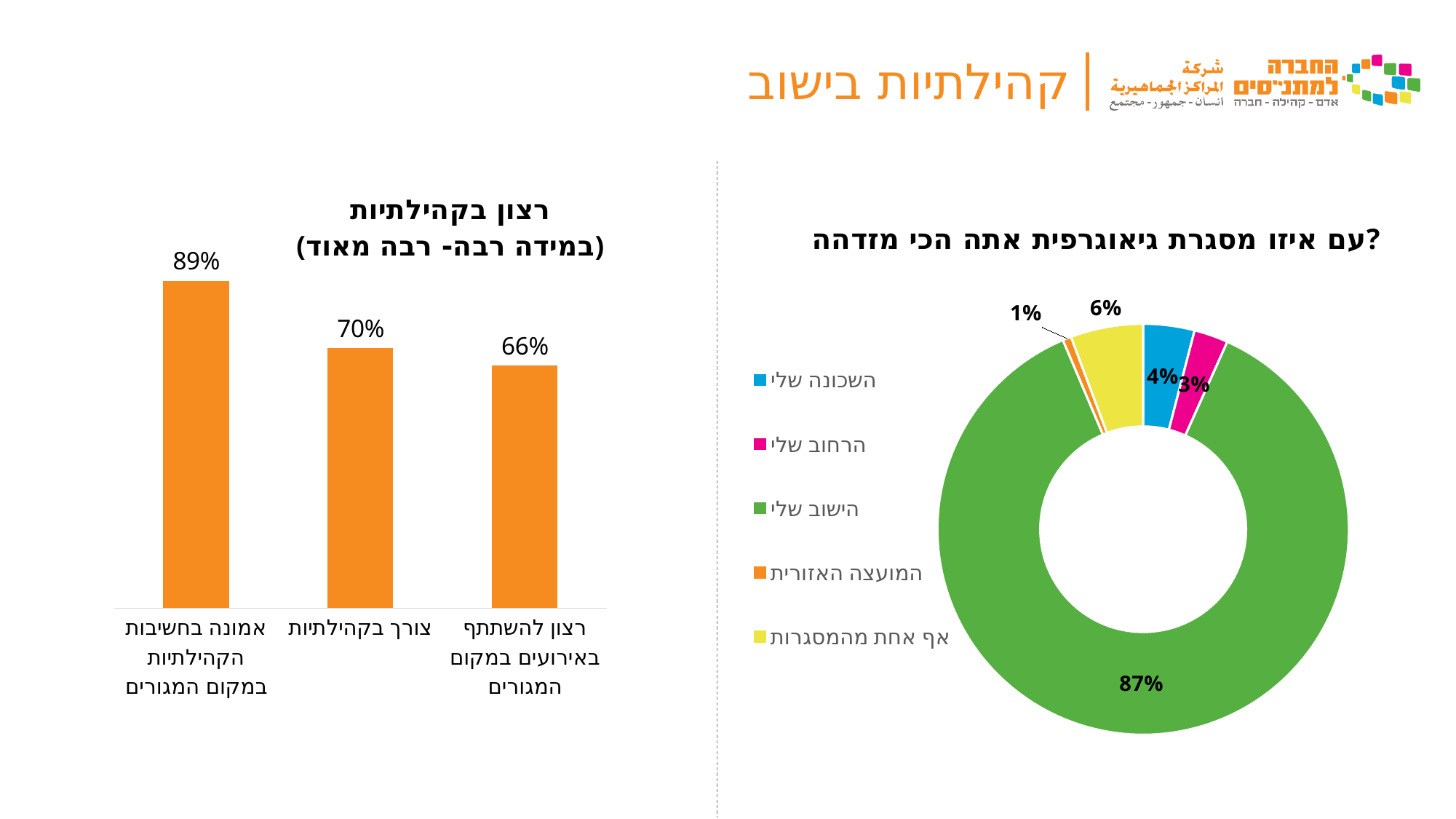
In the donut chart titled "עם איזו מסגרת גיאוגרפית אתה הכי מזדהה?", what is the share for "הישוב שלי"? 87% In the bar chart titled "רצון בקהילתיות (במידה רבה- רבה מאוד)", which category has the lowest value? רצון להשתתף באירועים במקום המגורים In the donut chart titled "עם איזו מסגרת גיאוגרפית אתה הכי מזדהה?", how many categories does the legend list? 5 In the bar chart titled "רצון בקהילתיות (במידה רבה- רבה מאוד)", how many categories are shown? 3 In the donut chart titled "עם איזו מסגרת גיאוגרפית אתה הכי מזדהה?", what is the value for "אף אחת מהמסגרות"? 6% What kind of chart is the chart on the left side of the slide? Bar chart In the donut chart titled "עם איזו מסגרת גיאוגרפית אתה הכי מזדהה?", which is larger: "השכונה שלי" or "הרחוב שלי"? השכונה שלי In the bar chart titled "רצון בקהילתיות (במידה רבה- רבה מאוד)", what is the difference between "אמונה בחשיבות הקהילתיות במקום המגורים" and "רצון להשתתף באירועים במקום המגורים"? 23% In the donut chart titled "עם איזו מסגרת גיאוגרפית אתה הכי מזדהה?", which category has the smallest share? המועצה האזורית In the donut chart titled "עם איזו מסגרת גיאוגרפית אתה הכי מזדהה?", what colour represents "הישוב שלי"? Green In the bar chart titled "רצון בקהילתיות (במידה רבה- רבה מאוד)", what is the value for "אמונה בחשיבות הקהילתיות במקום המגורים"? 89% In the bar chart titled "רצון בקהילתיות (במידה רבה- רבה מאוד)", what is the value for "צורך בקהילתיות"? 70%